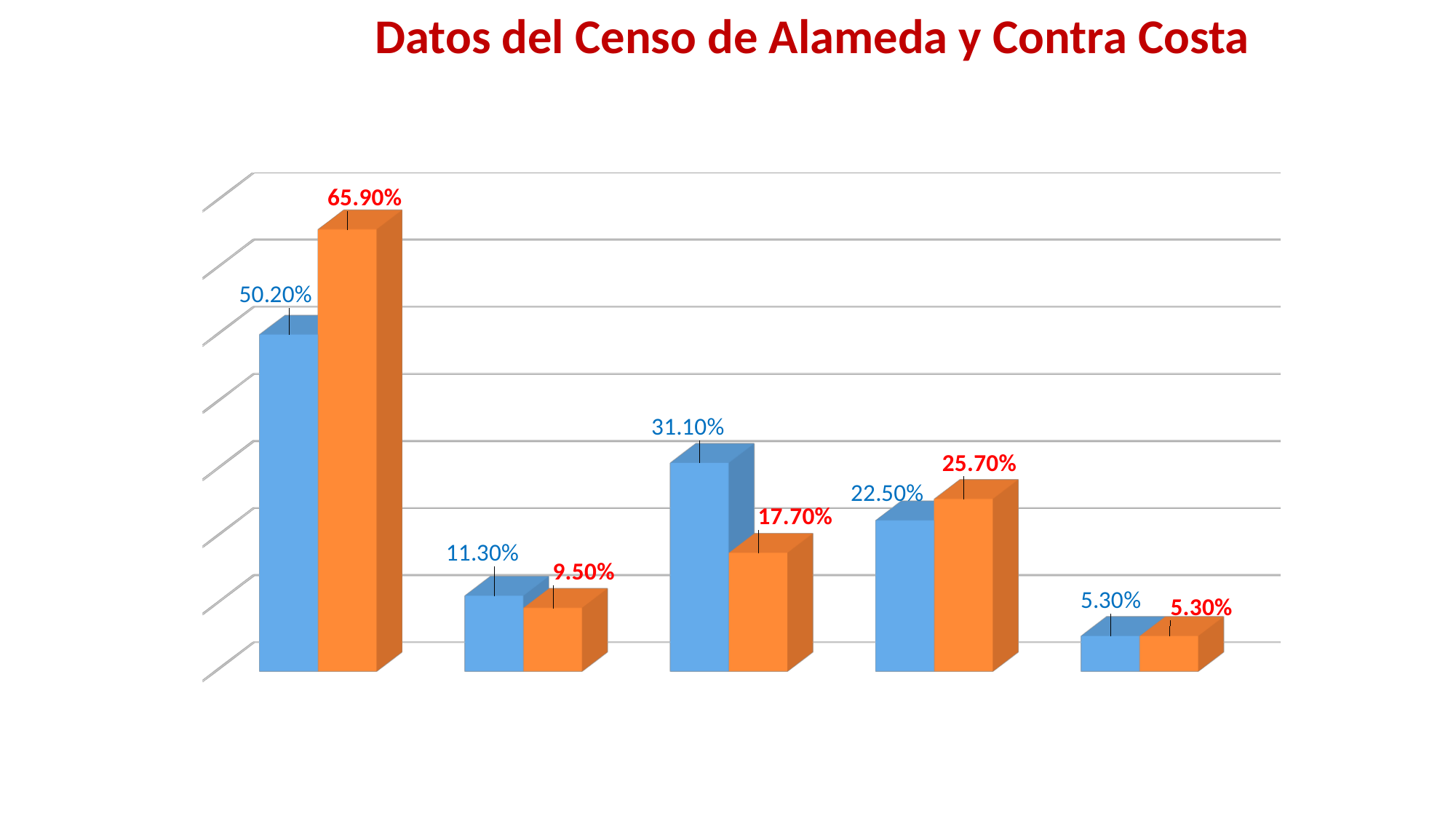
What type of chart is shown on the slide? bar chart Which group of bars has the lowest values in the chart? the fifth (rightmost) group What is the value of the blue bar in the first (leftmost) group? 50.20% What is the value of the orange bar in the first (leftmost) group? 65.90% What is the value of the blue bar in the third group? 31.10% What is the difference between the orange bar and the blue bar in the first (leftmost) group? 15.70% How many groups of bars (categories) are plotted in the chart? 5 What is the value of the orange bar in the fourth group? 25.70% What is the title of the chart? Datos del Censo de Alameda y Contra Costa What is the highest value shown in the chart? 65.90% In the second group, which bar is larger, the blue bar or the orange bar? the blue bar How many data series (bar colours) are plotted in the chart? 2